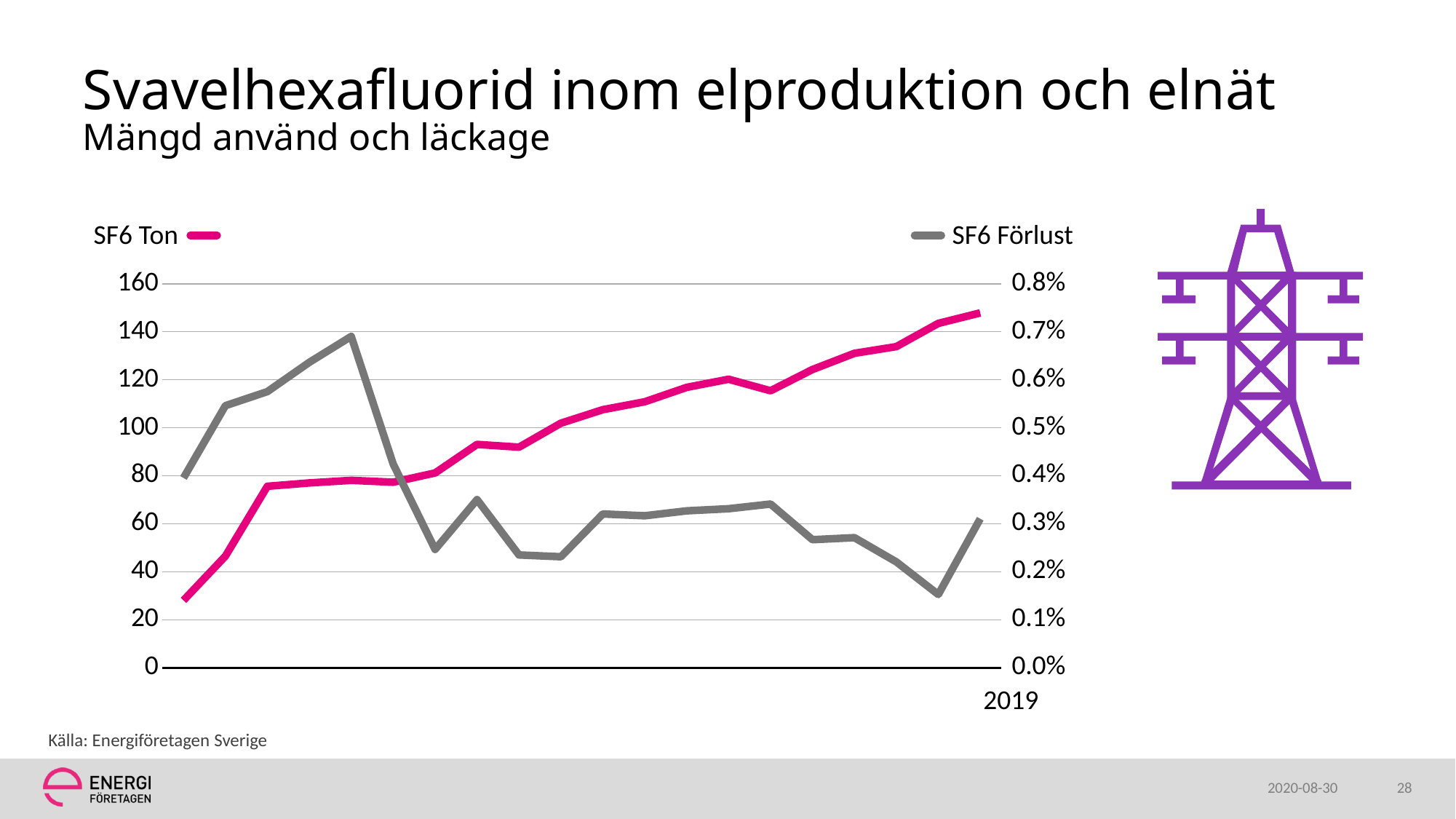
What is the highest tick shown on the right-hand axis? 0.8% Is the value of SF6 Ton at 2019 greater or less than 140? greater Is the lowest value of SF6 Förlust greater or less than 0.2%? less How many series does the chart's legend list? 2 Is the value of SF6 Förlust at 2019 greater or less than 0.4%? less Does the SF6 Ton series generally rise or fall along the x axis? rise Which series is drawn in grey? SF6 Förlust What kind of chart is shown on the slide? line chart Which series is drawn in pink? SF6 Ton